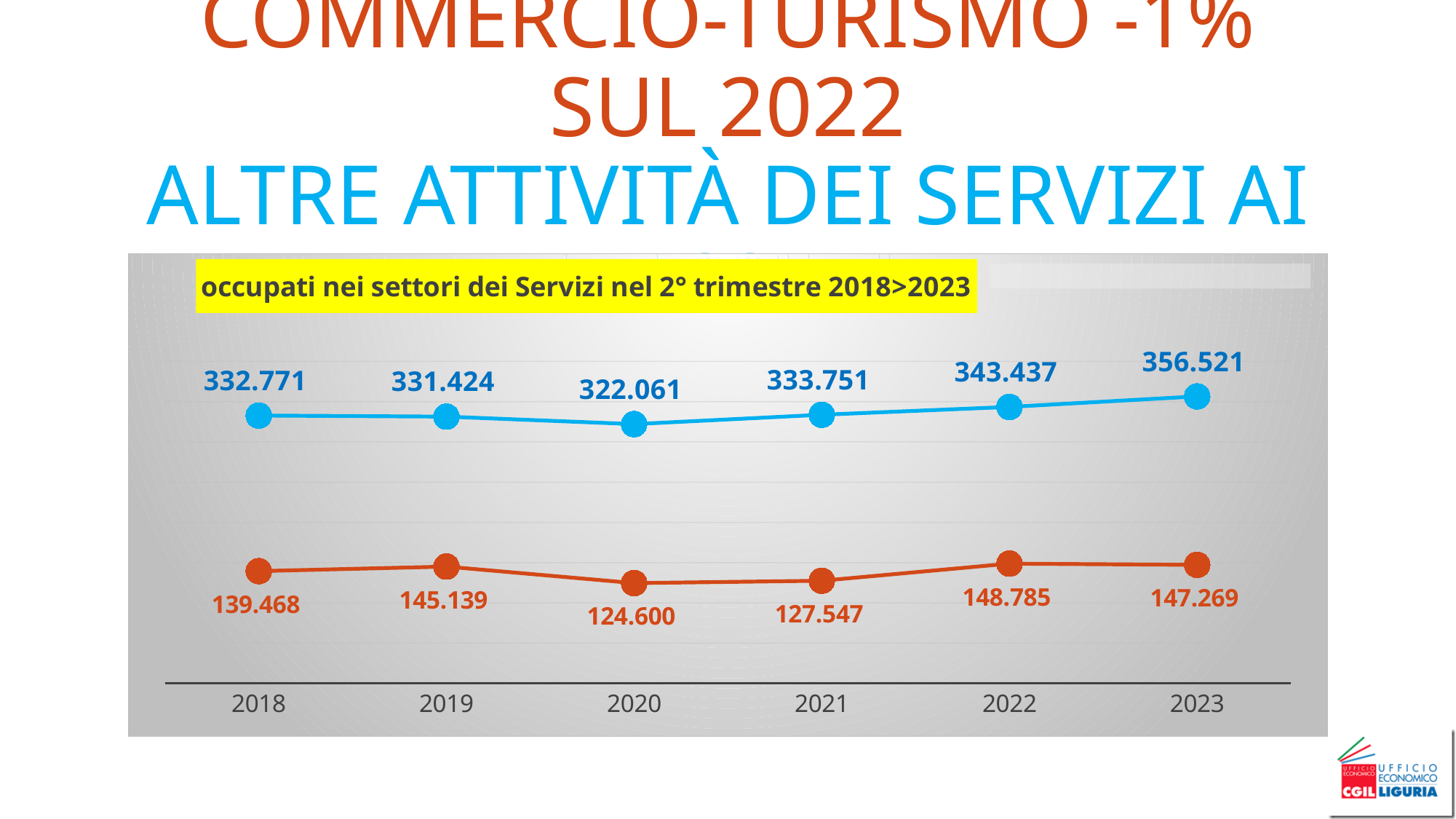
In which year does the blue line reach its highest value? 2023 What is the title of the chart? occupati nei settori dei Servizi nel 2° trimestre 2018>2023 What is the value of the orange line in 2020? 124.600 In which year does the orange line have its lowest value? 2020 What is the difference between the orange line's values in 2022 and 2023? 1.516 How many years are plotted on the x axis? 6 What is the value of the orange line in 2022? 148.785 In which year does the orange line reach its highest value? 2022 What type of chart is shown on the slide? line chart What is the value of the blue line in 2023? 356.521 What is the value of the blue line in 2020? 322.061 What is the difference between the blue line's values in 2023 and 2022? 13.084